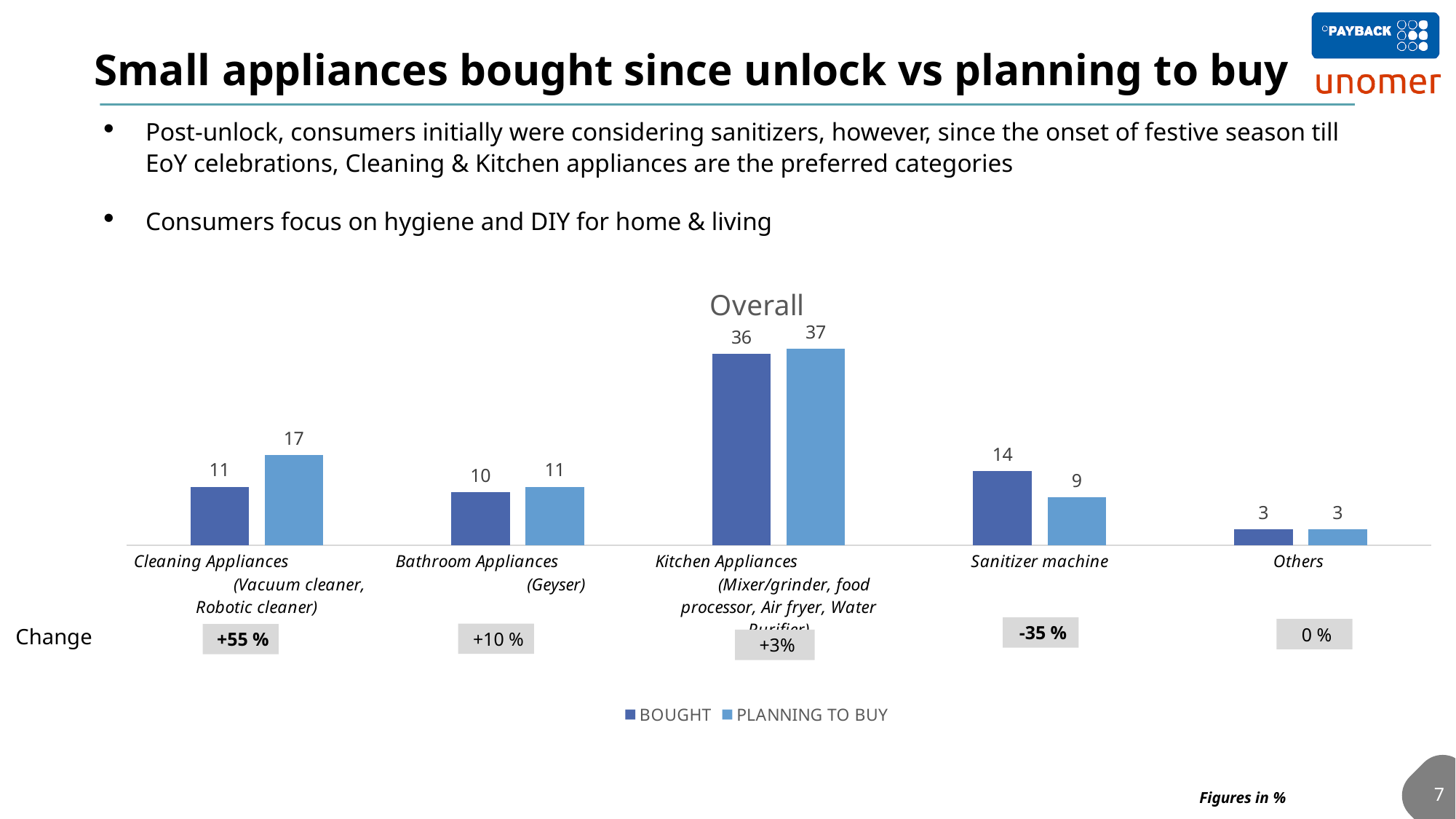
Which category has the highest PLANNING TO BUY value? Kitchen Appliances How many series does the legend list? 2 What is the difference between the PLANNING TO BUY and BOUGHT values for Cleaning Appliances? 6 Which category has the lowest BOUGHT value? Others For Sanitizer machine, which is larger: BOUGHT or PLANNING TO BUY? BOUGHT What is the BOUGHT value for Kitchen Appliances? 36 How many categories are shown on the x axis of the chart? 5 What is the Change value shown for Sanitizer machine? -35 % What is the PLANNING TO BUY value for Cleaning Appliances? 17 What kind of chart is shown on the slide? Bar chart What is the title of the chart? Overall What is the BOUGHT value for Sanitizer machine? 14